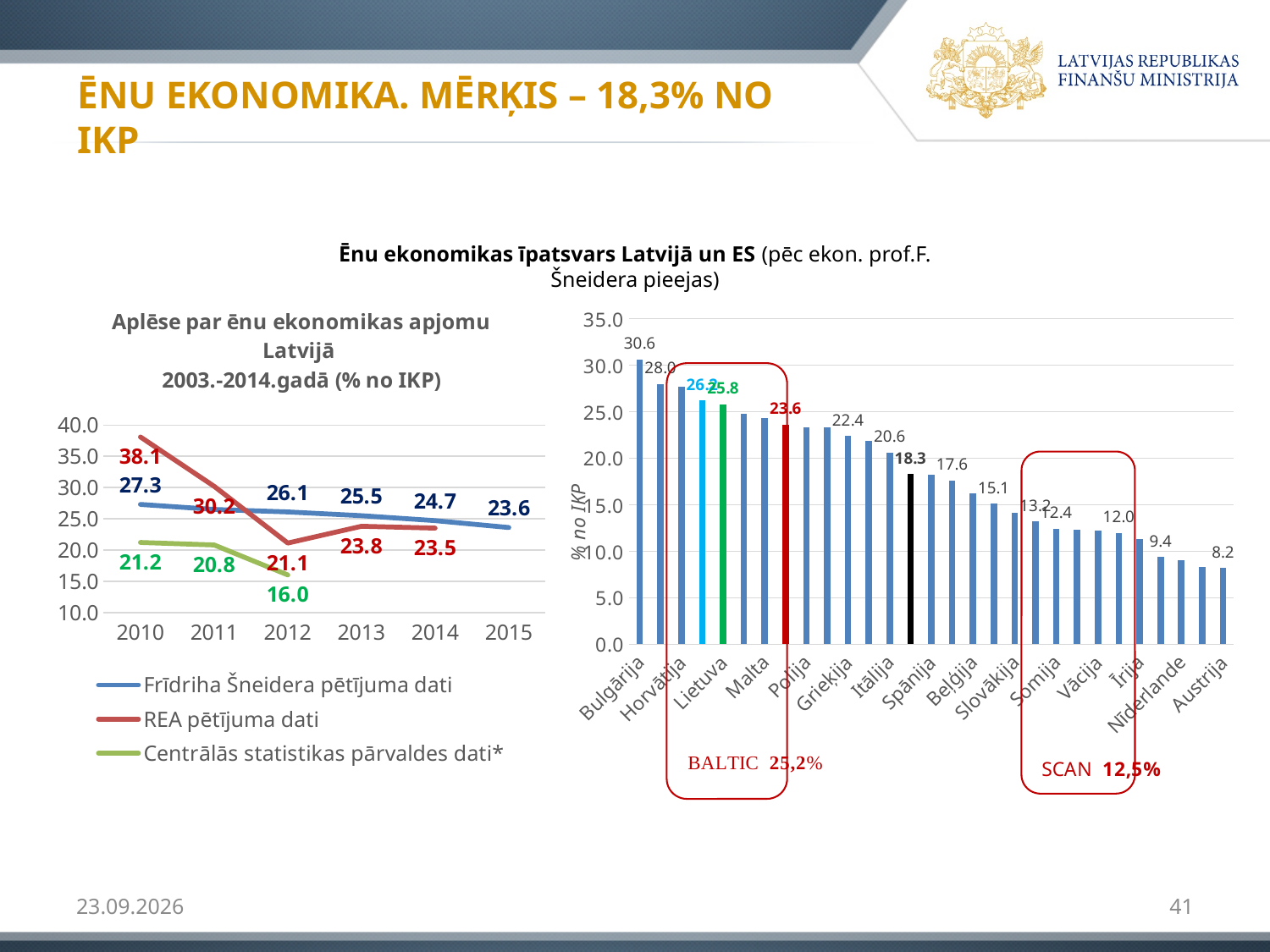
How many series does the legend of the left chart list? 3 What kind of chart is the right chart titled 'Ēnu ekonomikas īpatsvars Latvijā un ES'? bar chart In the right chart, what value is labelled on the black bar? 18.3 In the left chart, what is the value of 'REA pētījuma dati' for 2010? 38.1 In the left chart, does the 'Frīdriha Šneidera pētījuma dati' series rise or fall from 2010 to 2015? fall In the right chart, which country has the highest value? Bulgārija In the right chart, what is the value for Austrija? 8.2 In the left chart, by how much did 'REA pētījuma dati' fall from 2010 to 2011? 7.9 In the left chart, what is the value of 'Centrālās statistikas pārvaldes dati*' for 2012? 16.0 In the left chart, what is the value of 'Frīdriha Šneidera pētījuma dati' for 2015? 23.6 In the left chart, which series has the higher value in 2010: 'REA pētījuma dati' or 'Frīdriha Šneidera pētījuma dati'? REA pētījuma dati What kind of chart is the left chart titled 'Aplēse par ēnu ekonomikas apjomu Latvijā'? line chart